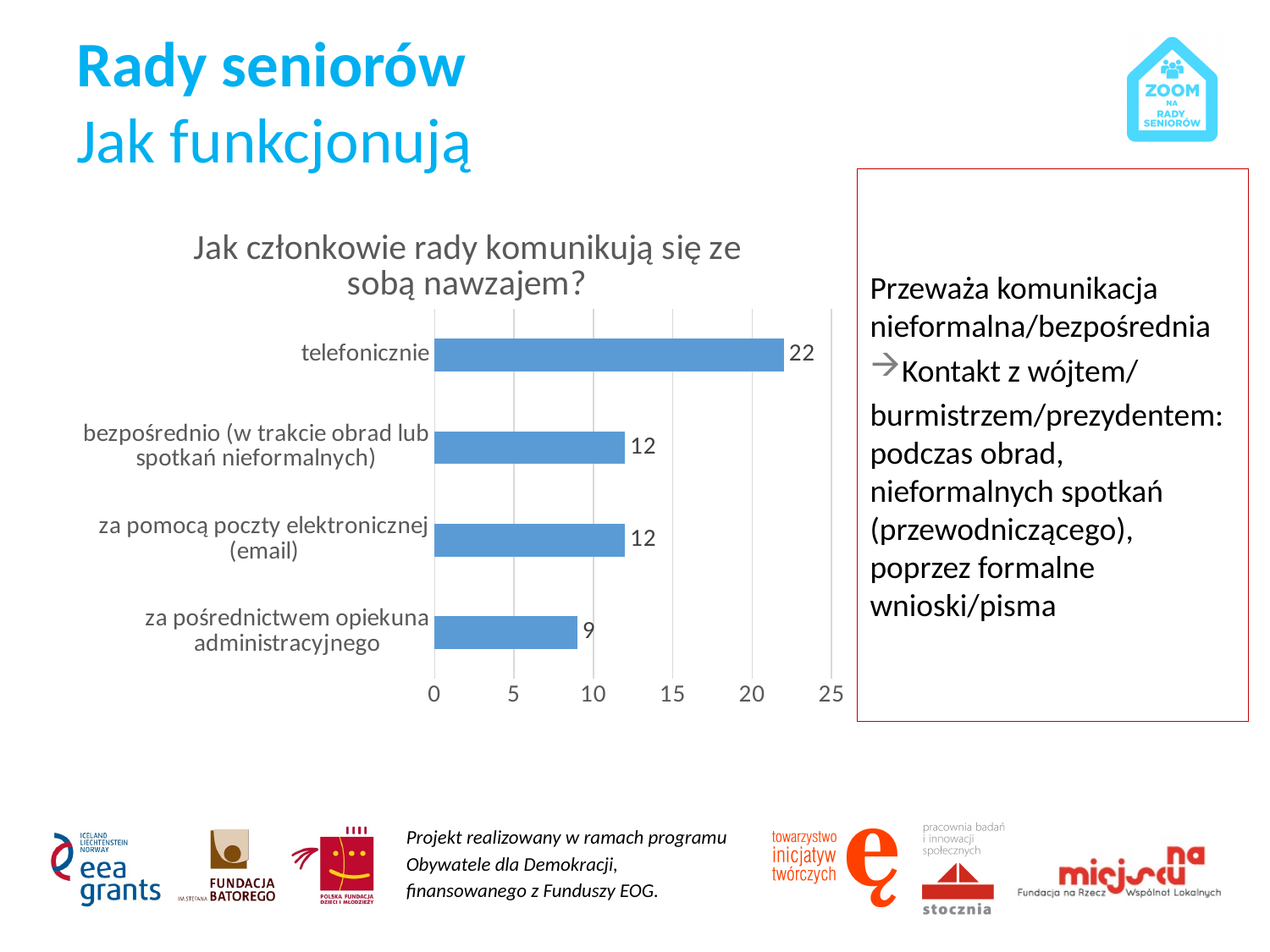
What is the difference between the values for "za pomocą poczty elektronicznej (email)" and "za pośrednictwem opiekuna administracyjnego"? 3 What is the value for "za pomocą poczty elektronicznej (email)"? 12 How many categories are shown in the chart? 4 What kind of chart is shown on the slide? bar chart Is the value for "telefonicznie" greater or less than 20? greater Which category has the highest value? telefonicznie What is the title of the chart? Jak członkowie rady komunikują się ze sobą nawzajem? Which is larger: the value for "telefonicznie" or the value for "za pośrednictwem opiekuna administracyjnego"? telefonicznie Which category has the lowest value? za pośrednictwem opiekuna administracyjnego What is the value for "za pośrednictwem opiekuna administracyjnego"? 9 What is the difference between the values for "telefonicznie" and "bezpośrednio (w trakcie obrad lub spotkań nieformalnych)"? 10 What is the value for "telefonicznie"? 22